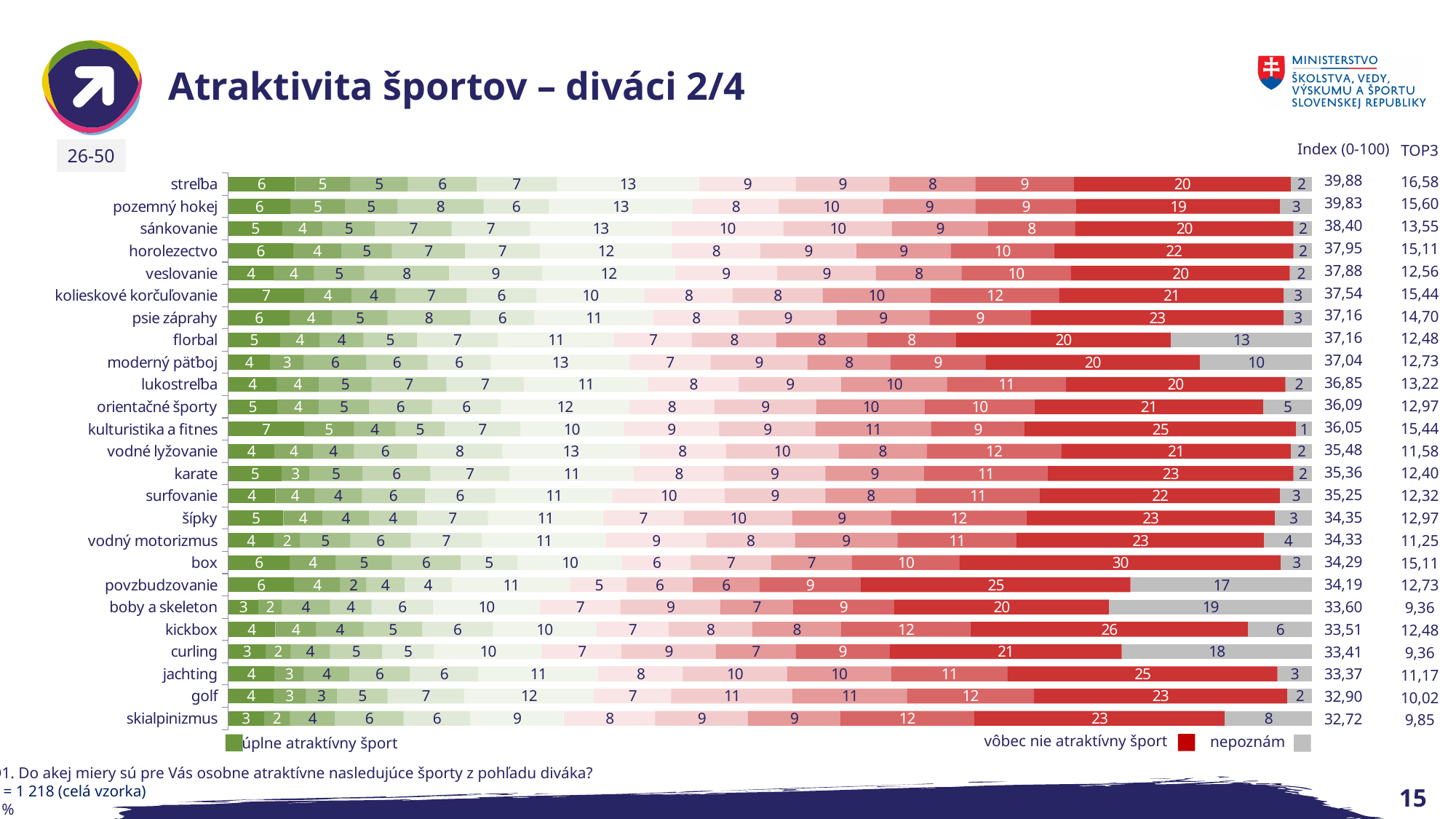
Which sport has the highest 'nepoznám' value? boby a skeleton What is the 'nepoznám' value for florbal? 13 Which sport has the highest Index (0-100) value? streľba Which sport has the lowest Index (0-100) value? skialpinizmus What is the TOP3 value for skialpinizmus? 9,85 What is the 'vôbec nie atraktívny šport' value for box? 30 What kind of chart is shown on the slide? bar chart What is the difference between the Index (0-100) values of streľba and skialpinizmus? 7,16 Which has a larger 'nepoznám' value, povzbudzovanie or curling? curling What is the Index (0-100) value for streľba? 39,88 What is the title of the chart slide? Atraktivita športov – diváci 2/4 How many sports are listed in the chart? 25